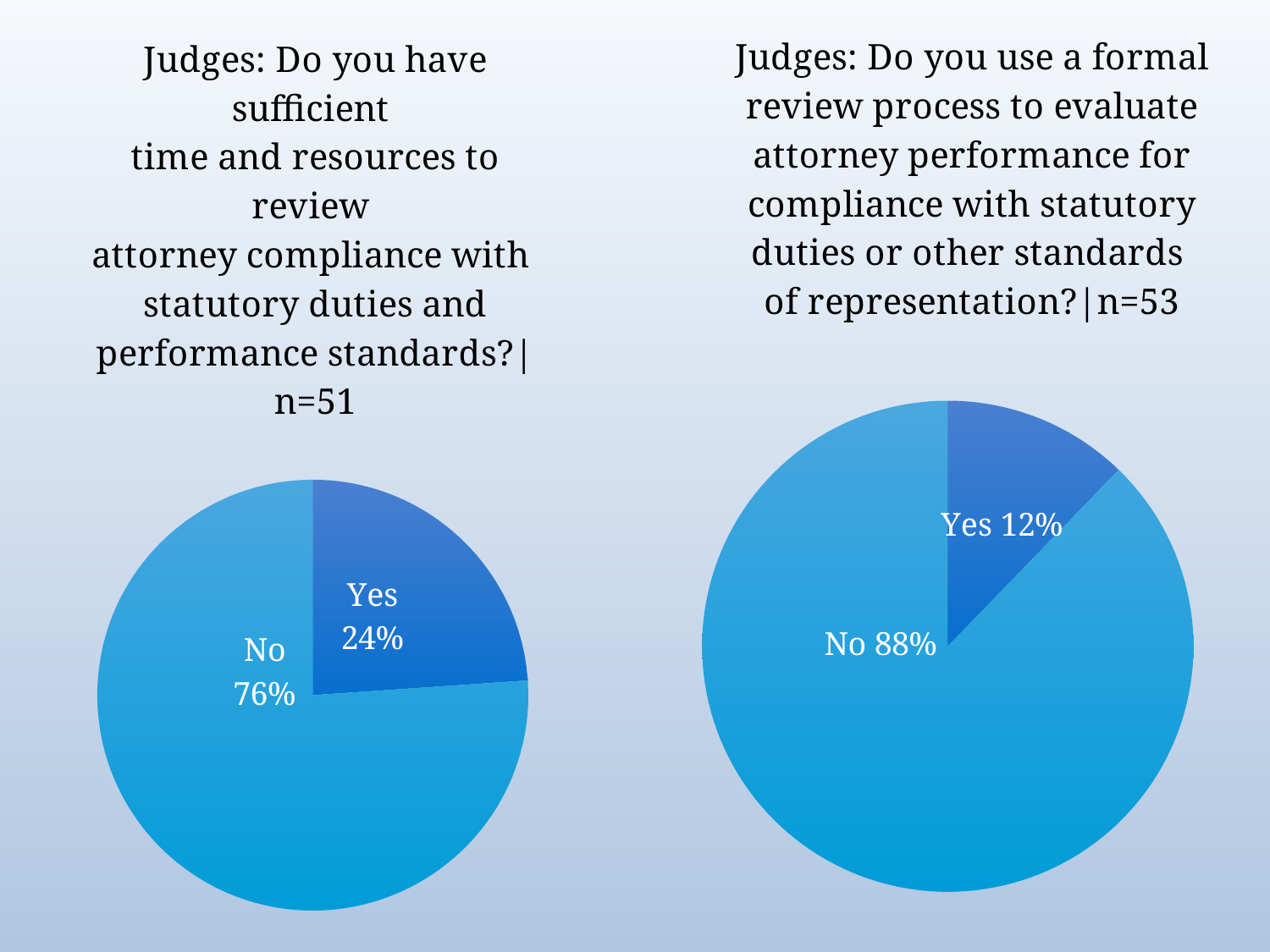
In the left pie chart (sufficient time and resources), what share of judges answered No? 76% In the right pie chart (formal review process), what share of judges answered Yes? 12% In the right pie chart (formal review process), what share of judges answered No? 88% In the right pie chart (formal review process), what is the difference in percentage points between the No and Yes slices? 76 What is the sample size (n) stated in the title of the right pie chart (formal review process)? n=53 In the left pie chart (sufficient time and resources), what is the difference in percentage points between the No and Yes slices? 52 In the right pie chart (formal review process), which response has the smallest slice? Yes What type of chart is used on the left side of the slide? Pie chart In the left pie chart (sufficient time and resources), which response has the largest slice? No Is the Yes share larger in the left pie chart (sufficient time and resources) or the right pie chart (formal review process)? Left pie chart How many slices does the right pie chart (formal review process) have? 2 In the left pie chart (sufficient time and resources), what share of judges answered Yes? 24%